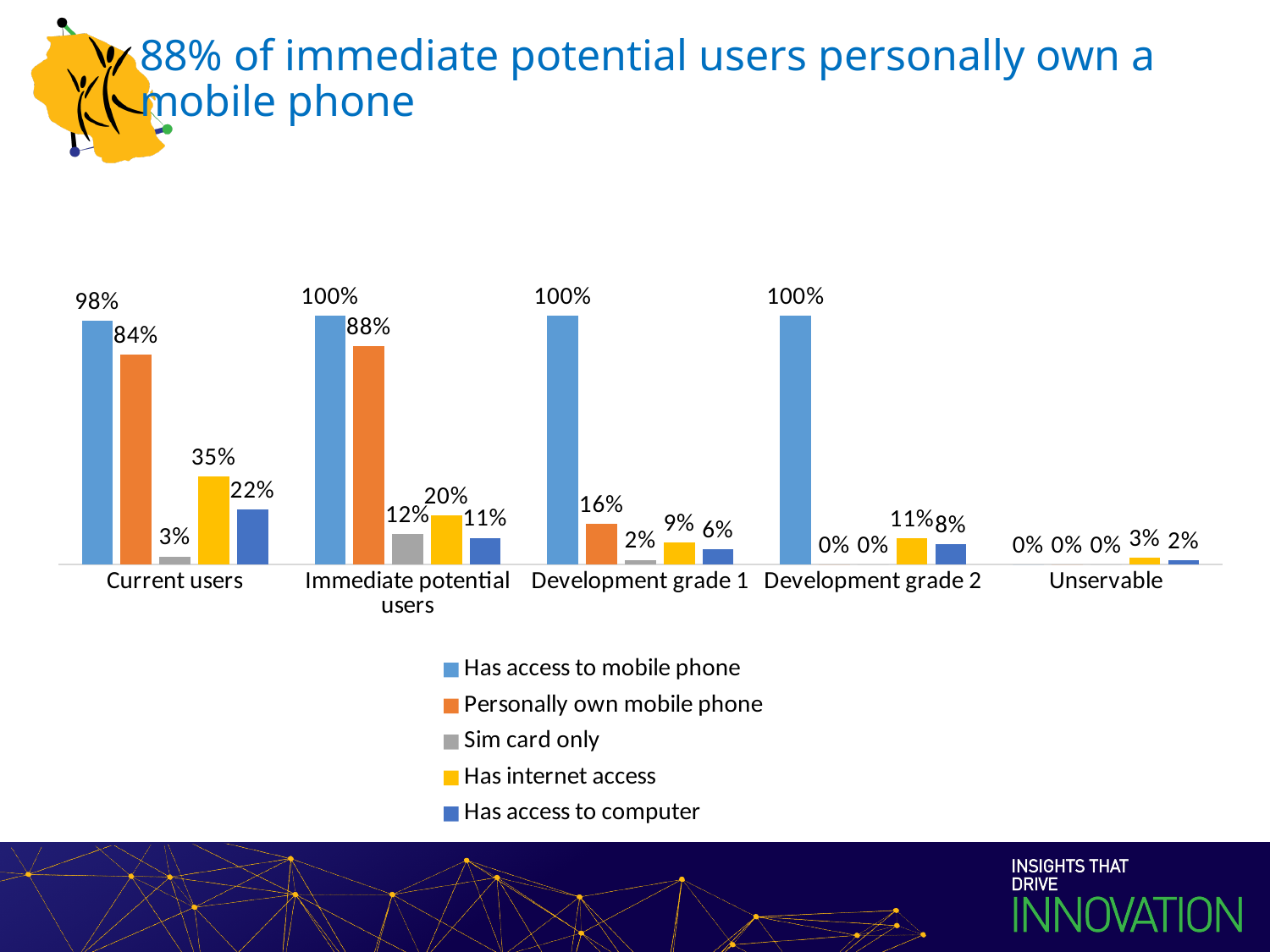
What is the value for 'Has internet access' among current users? 35% Which series is shown in orange in the legend? Personally own mobile phone Which is larger for immediate potential users: 'Sim card only' or 'Has internet access'? Has internet access What percentage of immediate potential users personally own a mobile phone? 88% What is the difference between 'Has access to mobile phone' and 'Personally own mobile phone' for current users? 14% How many categories are shown on the x axis? 5 What is the value for 'Has access to computer' in the Unservable group? 2% How many series does the legend list? 5 Which category has the highest value for 'Has internet access'? Current users Which category has the lowest value for 'Has access to mobile phone'? Unservable What kind of chart is shown on the slide? Bar chart What is the value for 'Sim card only' in the Development grade 1 group? 2%